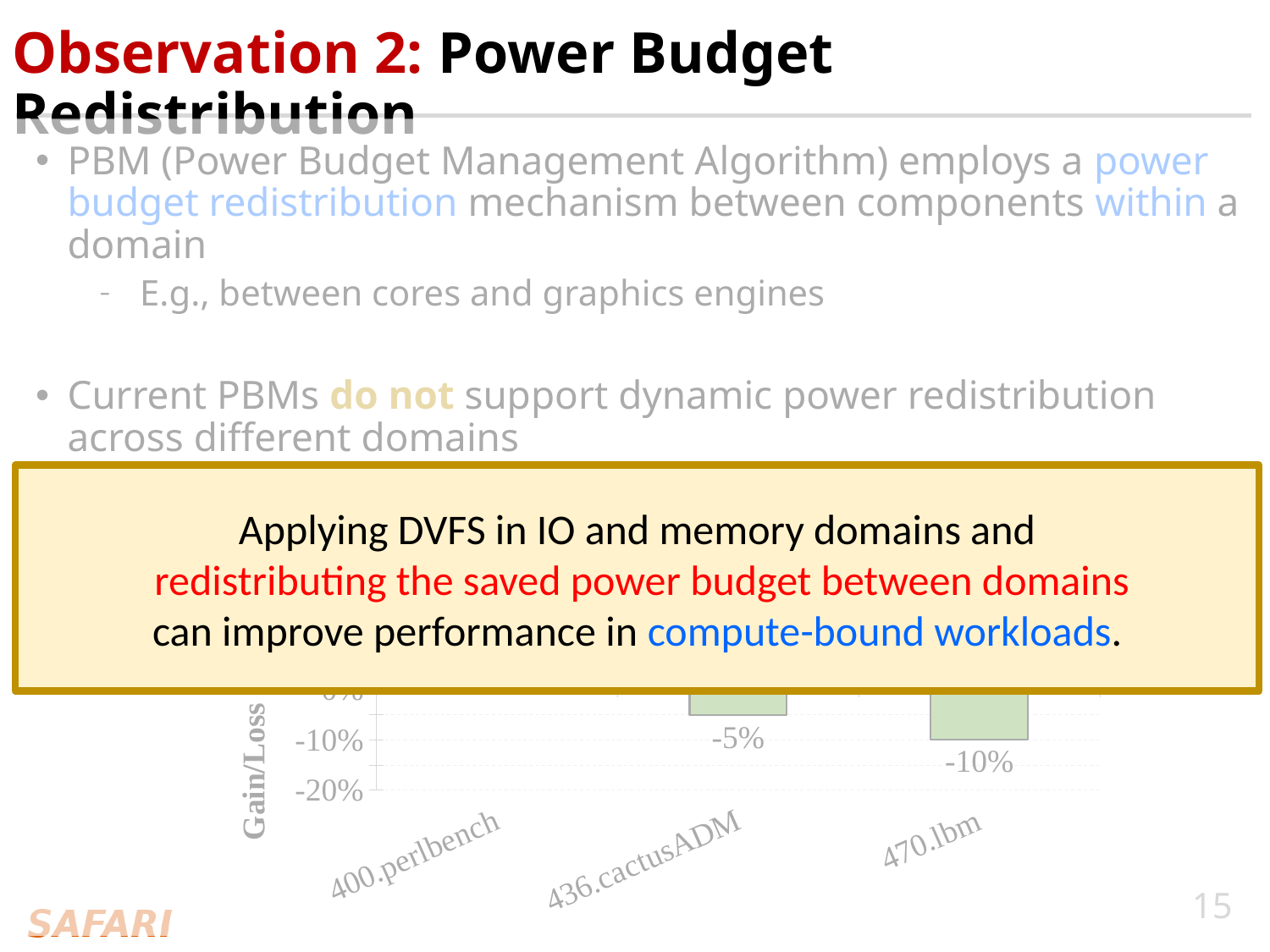
What kind of chart is shown at the bottom of the slide? Bar chart Which has the lower Gain/Loss value, 436.cactusADM or 470.lbm? 470.lbm Is the value for 470.lbm greater or less than -20%? greater Which has the higher Gain/Loss value, 436.cactusADM or 470.lbm? 436.cactusADM What is the Gain/Loss value shown for 436.cactusADM? -5% What is the difference between the Gain/Loss values for 436.cactusADM and 470.lbm? 5% What is the Gain/Loss value shown for 470.lbm? -10% What is the lowest tick value shown on the y axis of the chart? -20% Is the value for 436.cactusADM greater or less than -10%? greater What is the label on the y axis of the chart? Gain/Loss How many workload categories are shown on the x axis of the chart? 3